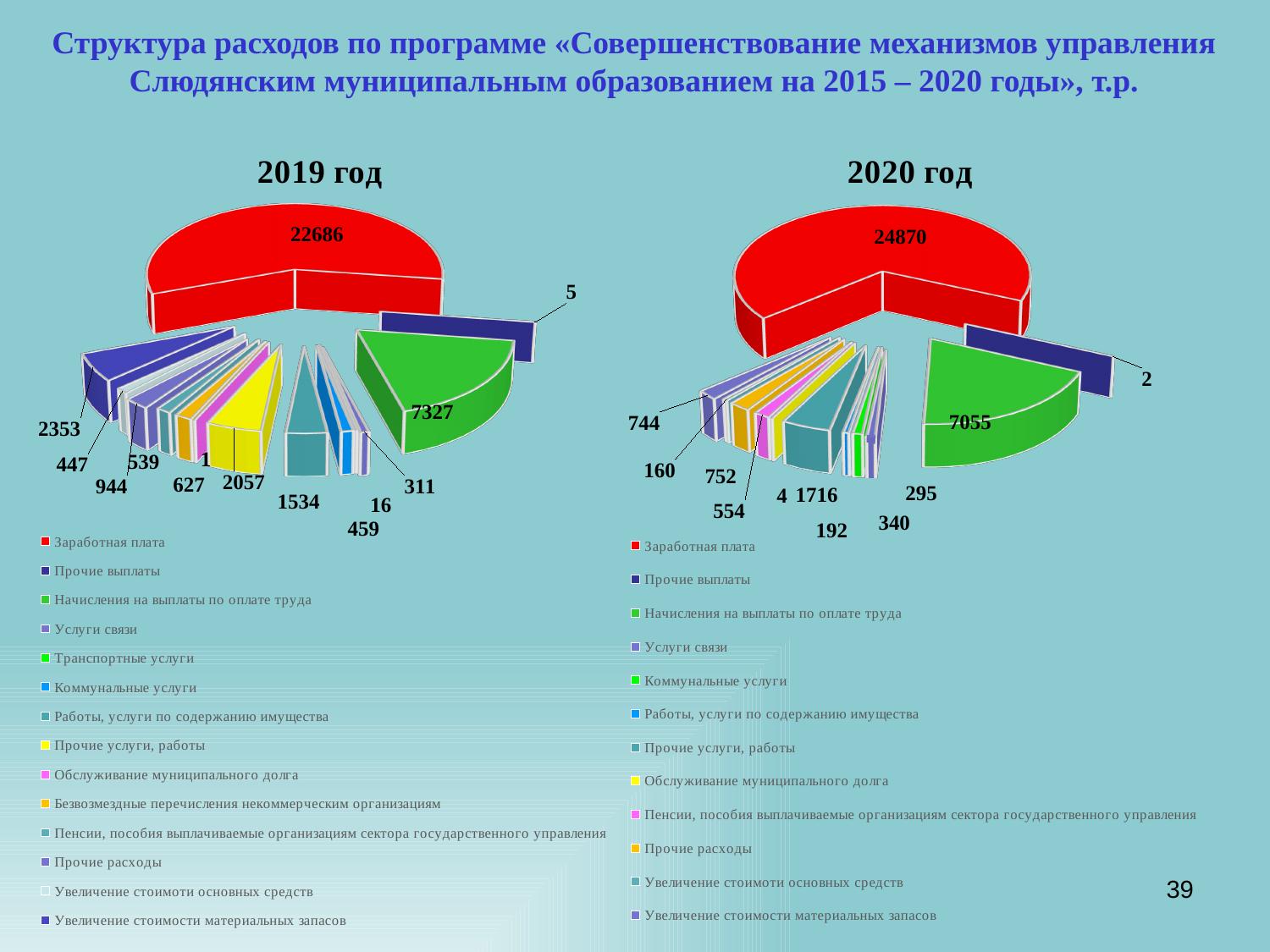
In the 2020 год chart, what is the value for Прочие выплаты? 2 In the 2019 год chart, what is the value of the largest slice? 22686 What kind of chart is used for the 2019 год chart? pie chart In the 2019 год chart, what is the difference between Заработная плата and Начисления на выплаты по оплате труда? 15359 How many entries does the legend of the 2019 год chart list? 14 In the 2020 год chart, what is the value for Начисления на выплаты по оплате труда? 7055 In the 2019 год chart, what is the value for Прочие выплаты? 5 How many entries does the legend of the 2020 год chart list? 12 Which is larger: Начисления на выплаты по оплате труда in the 2019 год chart or in the 2020 год chart? 2019 год In the 2020 год chart, what is the value of the largest slice? 24870 In the 2019 год chart, what is the value for Заработная плата? 22686 What is the difference between the Заработная плата value in the 2020 год chart and in the 2019 год chart? 2184